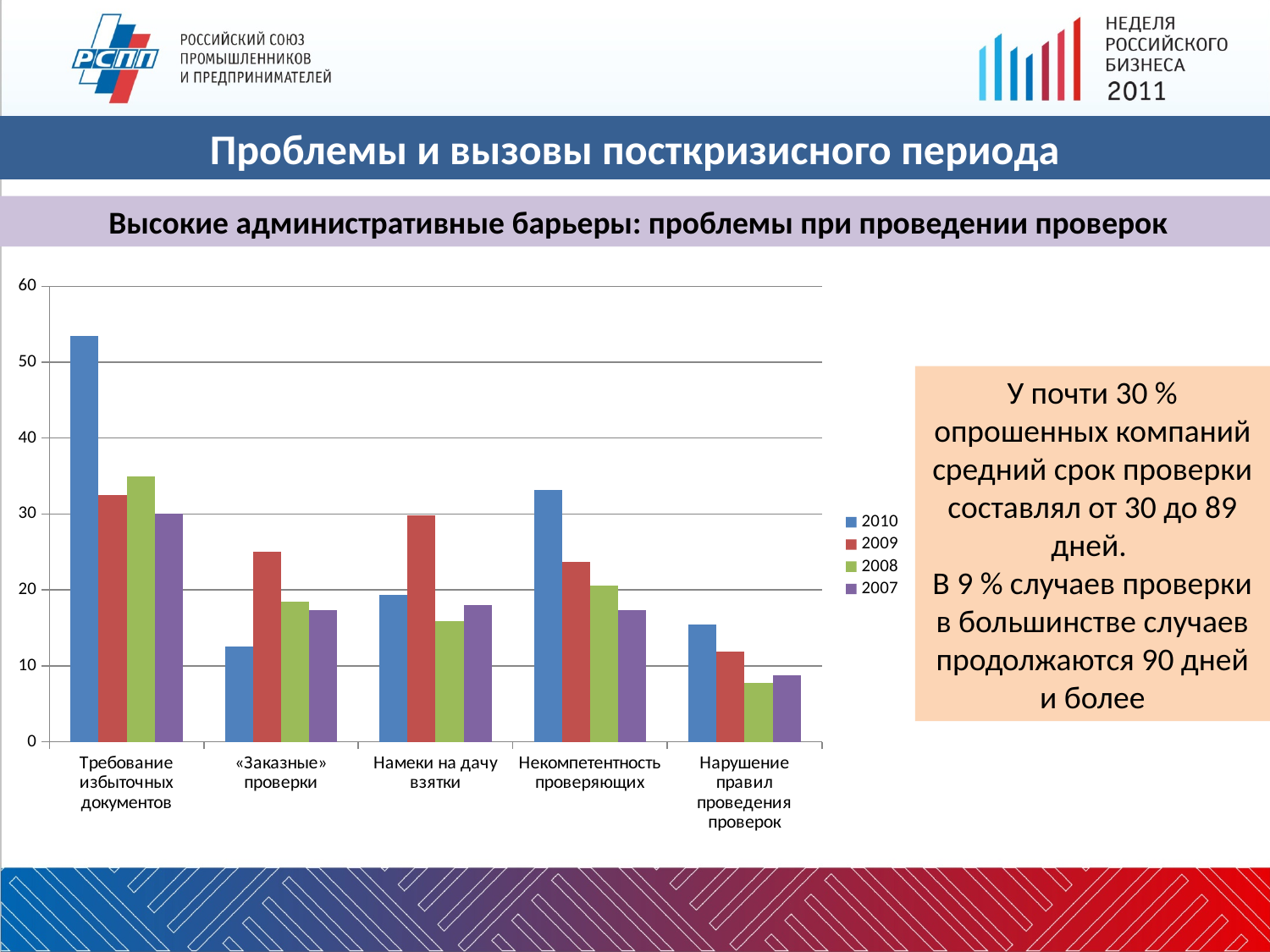
For Некомпетентность проверяющих, which series has the larger value: 2010 or 2007? 2010 For «Заказные» проверки, which series has the larger value: 2010 or 2009? 2009 Which category has the highest value for the 2010 series? Требование избыточных документов How many series does the chart's legend list? 4 Which series are listed in the chart's legend? 2010, 2009, 2008, 2007 Which category has the lowest value for the 2008 series? Нарушение правил проведения проверок Is the 2008 value for Нарушение правил проведения проверок greater or less than 10? less Is the 2010 value for Требование избыточных документов greater or less than 50? greater For Намеки на дачу взятки, which year has the highest value? 2009 Is the 2009 value for Намеки на дачу взятки greater or less than 25? greater How many categories are shown on the x axis of the chart? 5 What kind of chart is shown on the slide? bar chart